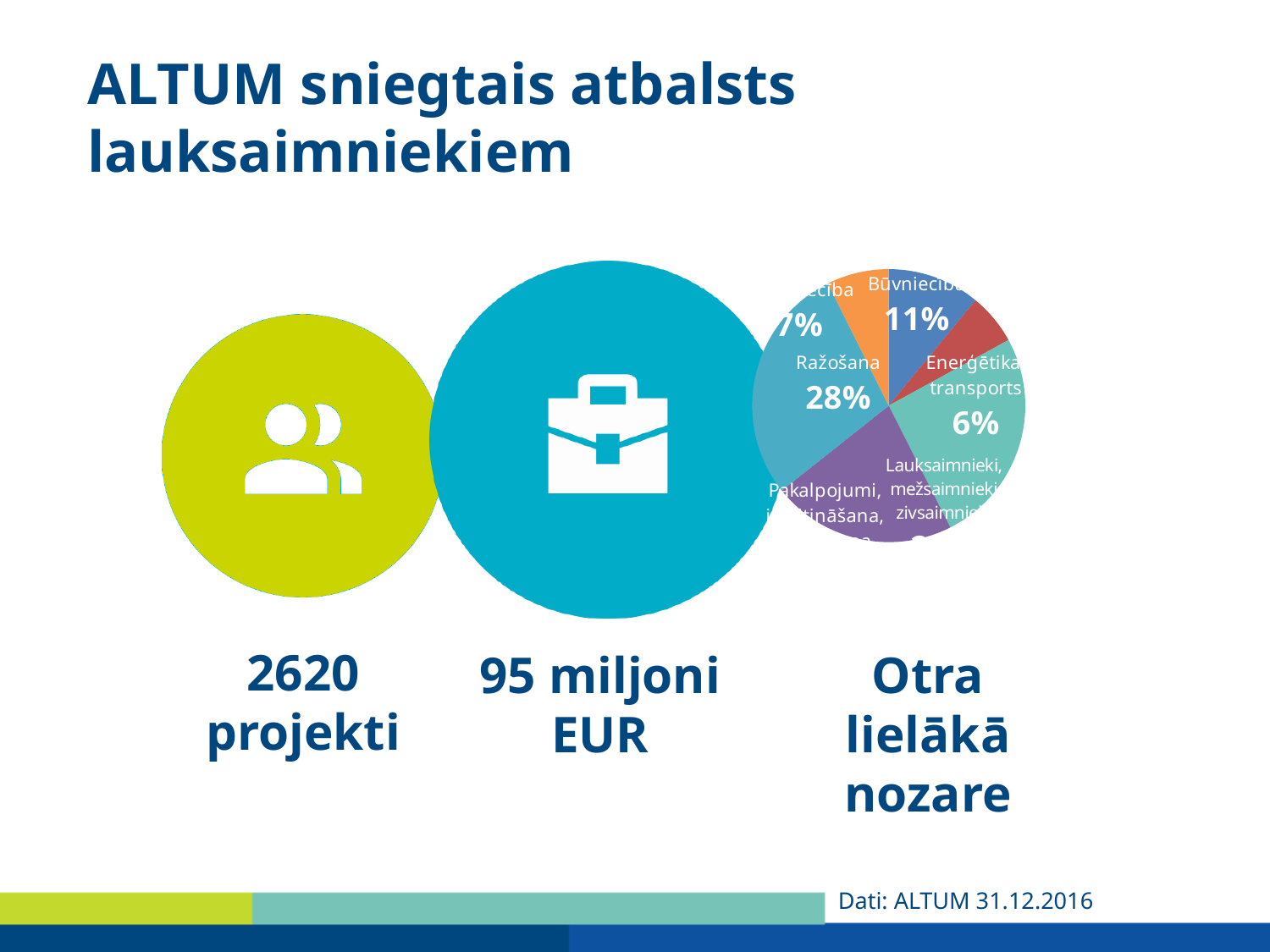
What colour is the Enerģētika, transports slice in the pie chart? teal In the pie chart, what share does Enerģētika, transports have? 6% In the pie chart, which is larger: Ražošana or Būvniecība? Ražošana In the pie chart, how many percentage points larger is Ražošana than Enerģētika, transports? 22% In the pie chart, how many percentage points larger is Ražošana than Būvniecība? 17% In the pie chart, which labelled sector has the largest share? Ražošana In the pie chart, what share does Ražošana have? 28% In the pie chart, what share does Būvniecība have? 11% What kind of chart is shown on the right of the slide? pie chart In the pie chart, which is larger: Būvniecība or Enerģētika, transports? Būvniecība What colour is the Ražošana slice in the pie chart? blue